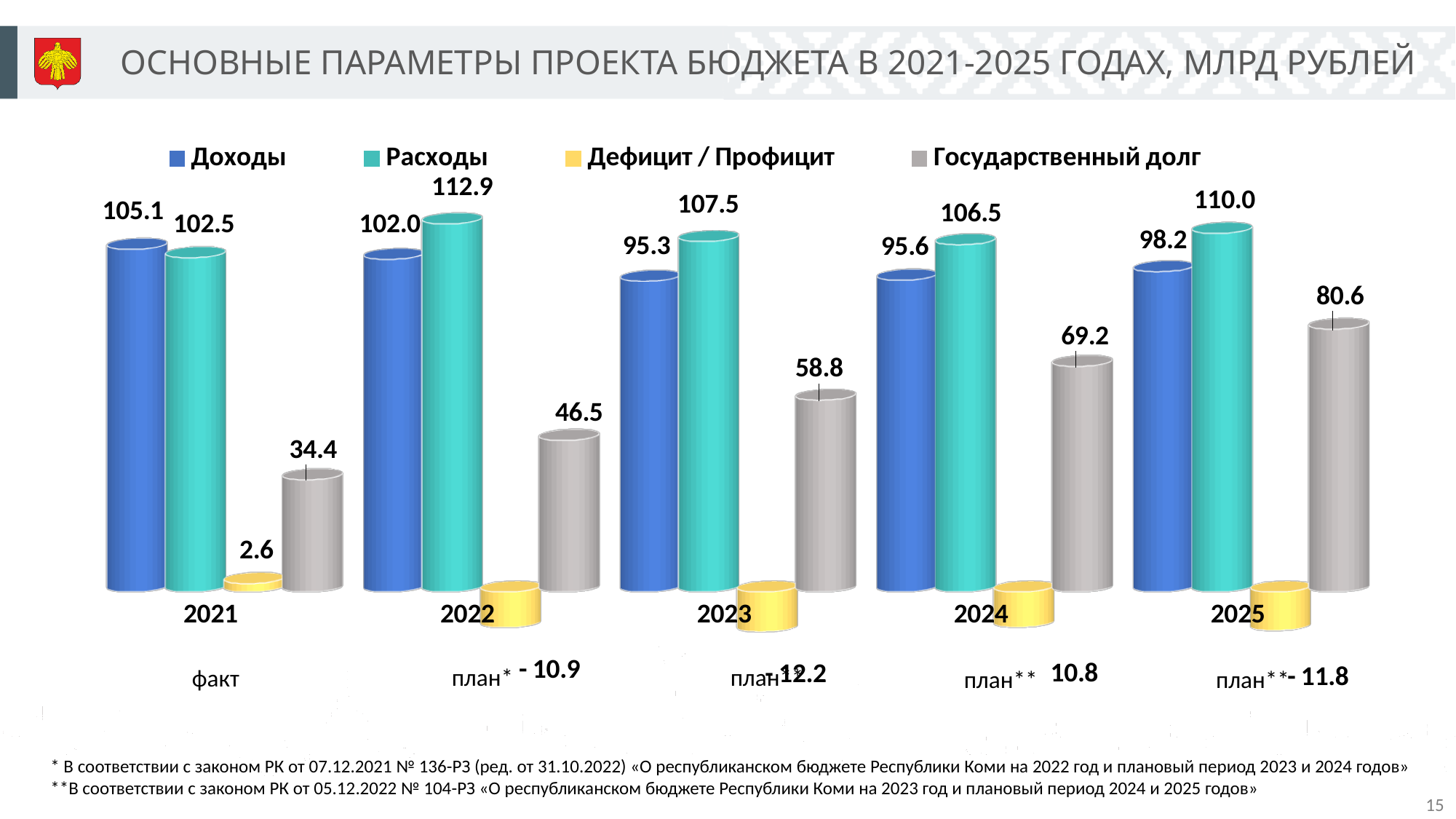
Does Государственный долг rise or fall from 2021 to 2025? Rises In which year is Доходы the lowest? 2023 What is the value of Расходы for 2022? 112.9 How many series does the legend list? 4 What kind of chart is shown on the slide? Bar chart By how much do Расходы exceed Доходы in 2025? 11.8 Which year has the larger Государственный долг, 2023 or 2024? 2024 What is the value of Государственный долг for 2025? 80.6 In which year is Расходы the highest? 2022 What is the value of Доходы for 2021? 105.1 What is the value of Дефицит / Профицит for 2021? 2.6 How many years are shown on the x axis? 5